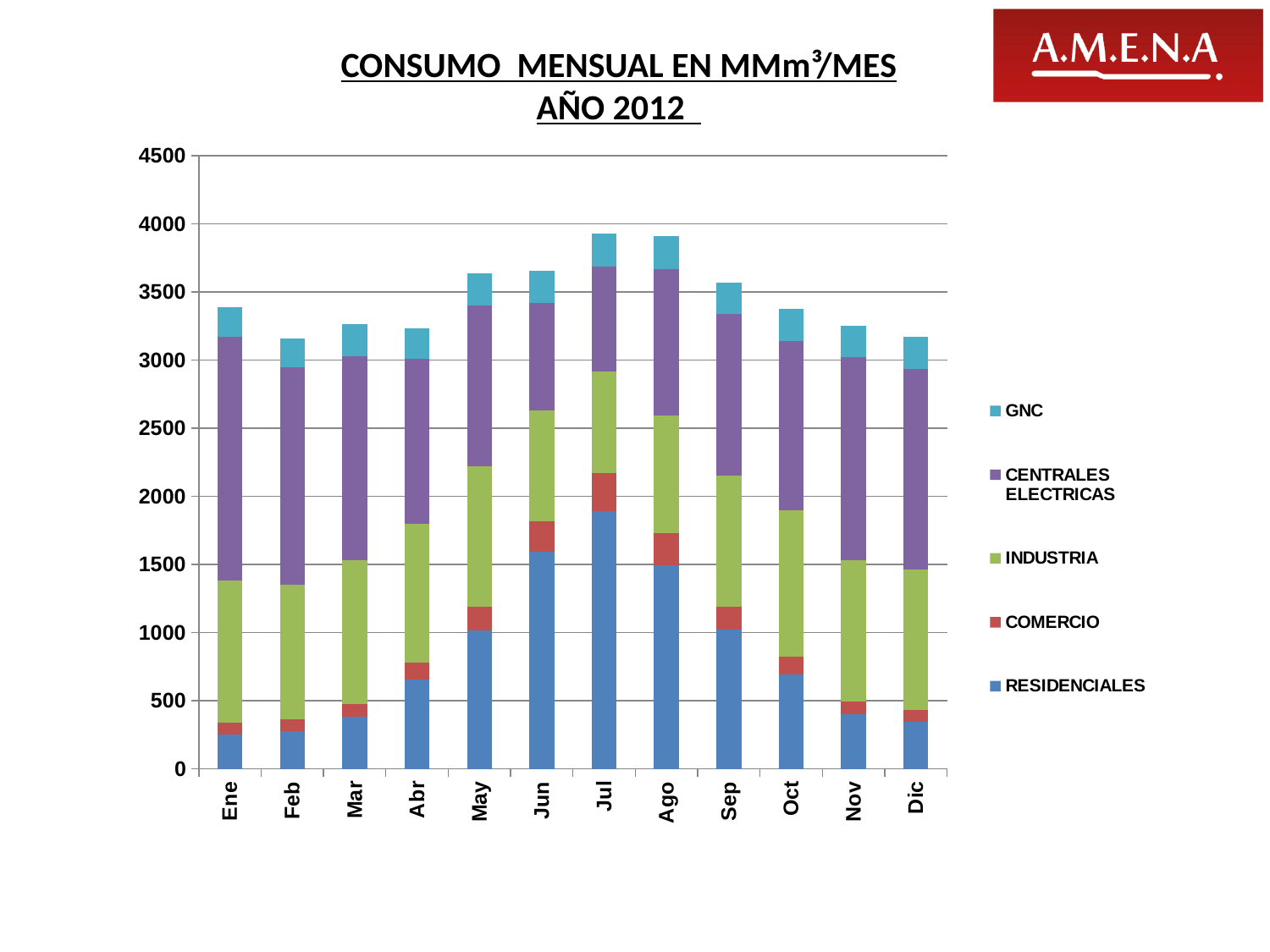
Which series is shown at the bottom of each stacked bar? RESIDENCIALES Which month has the tallest RESIDENCIALES (blue) segment? Jul Which month has the larger RESIDENCIALES segment, Jul or Ene? Jul What kind of chart is shown on the slide? stacked bar chart How many series does the legend list? 5 What is the title of the chart? CONSUMO MENSUAL EN MMm³/MES AÑO 2012 From Jul to Dic, do the total bar heights rise or fall? fall How many months (categories) are shown on the x axis? 12 Is the total bar height for Jul greater or less than 3500? greater Is the total bar height for Ene greater or less than 3000? greater Is the total bar height for Feb greater or less than 3500? less Which has the larger total bar, Jul or Feb? Jul